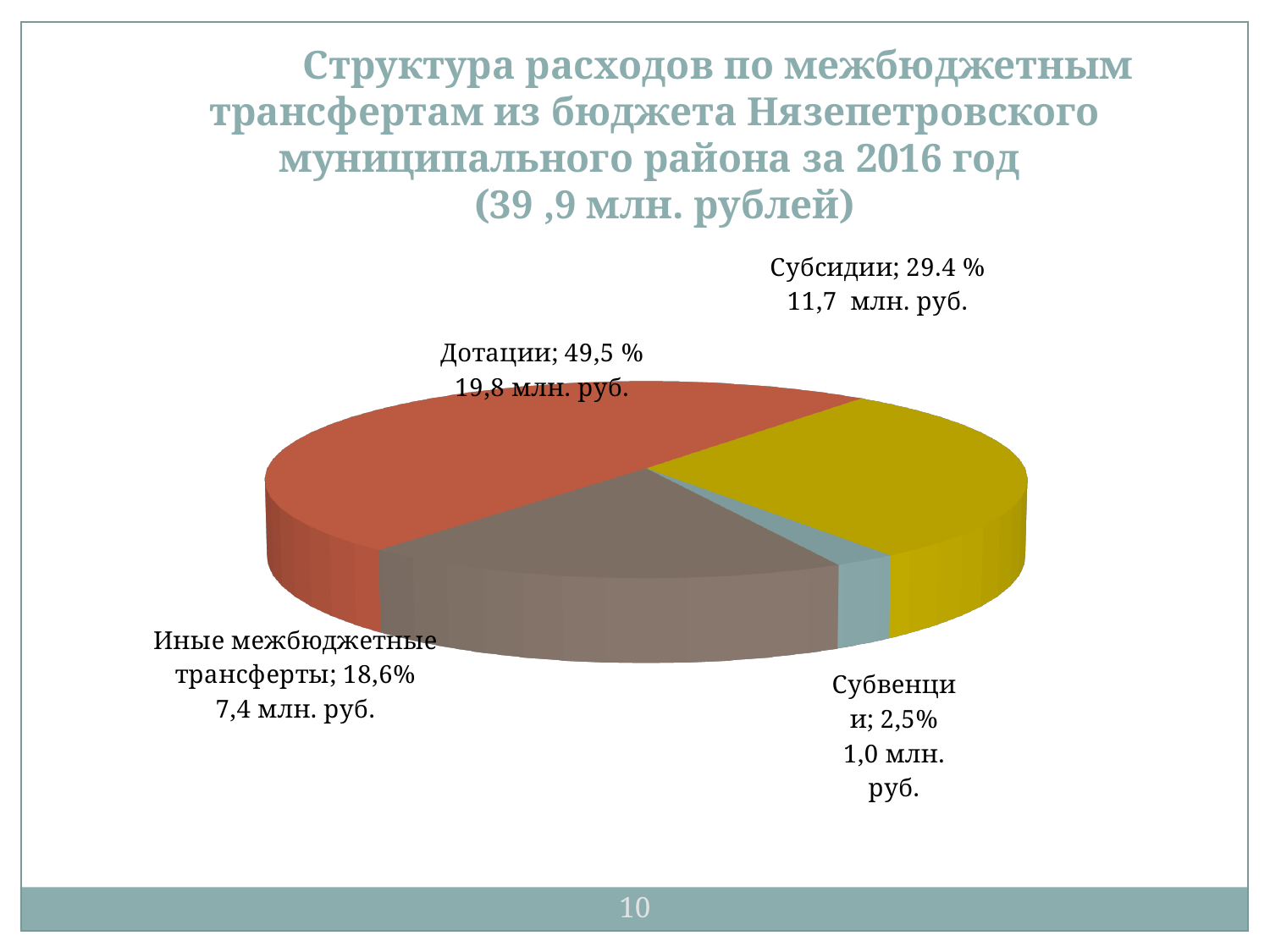
What is the value in млн. руб. for Субвенции? 1,0 млн. руб. What share of the pie does Субсидии represent? 29.4 % What is the difference in млн. руб. between Дотации and Субсидии? 8,1 млн. руб. What is the value in млн. руб. for Дотации? 19,8 млн. руб. Which is larger, Субсидии or Иные межбюджетные трансферты? Субсидии What share of the pie does Иные межбюджетные трансферты represent? 18,6% What kind of chart is shown on the slide? pie chart Which category has the smallest slice of the pie? Субвенции What share of the pie does Субвенции represent? 2,5% How many slices does the pie chart have? 4 Which category has the largest slice of the pie? Дотации